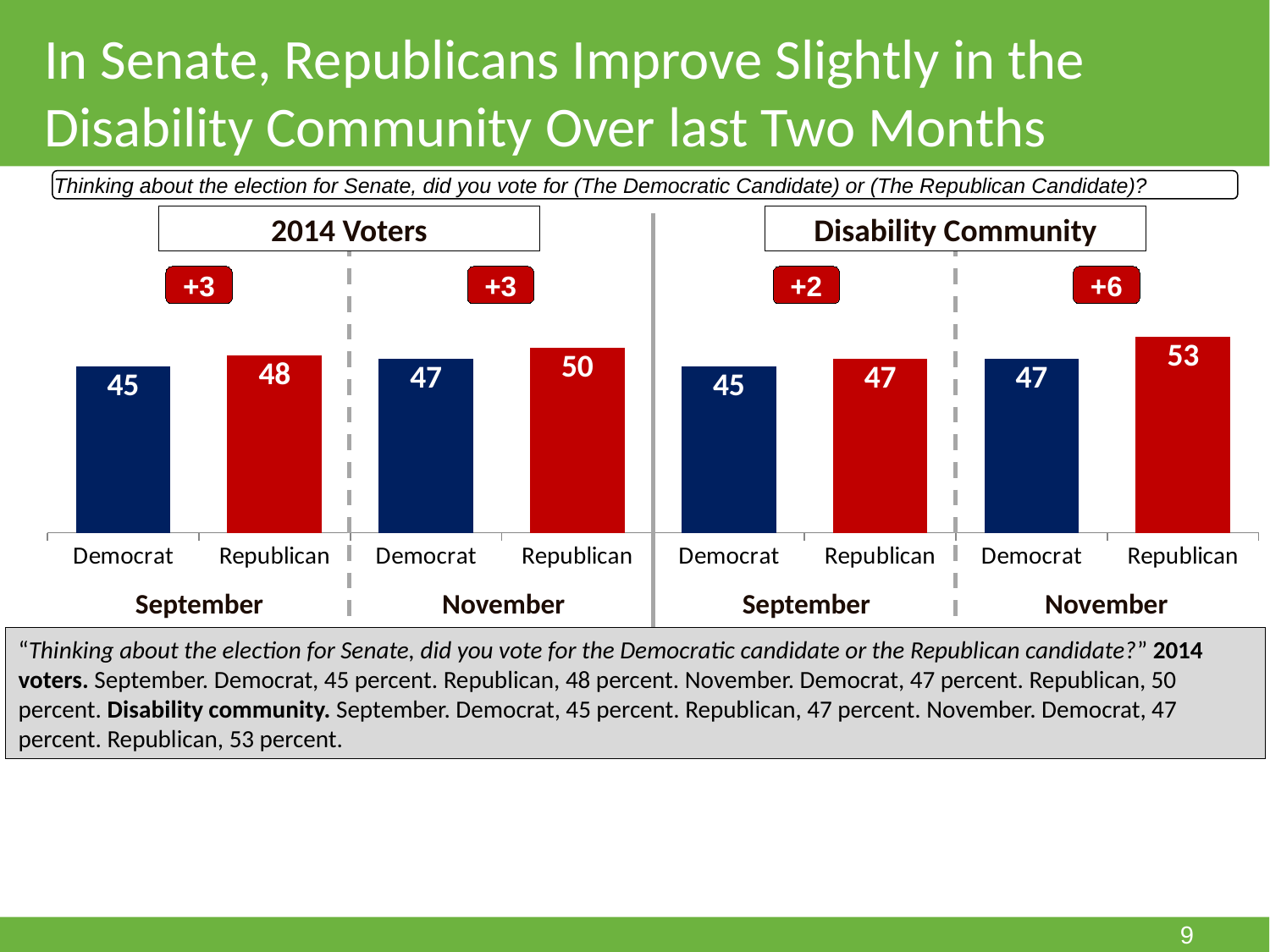
In the 2014 Voters chart, which is larger in September: Democrat or Republican? Republican What kind of chart is used on this slide? Bar chart In the Disability Community chart, what is the gain label shown above the November bars? +6 In the 2014 Voters chart, what is the value for Republican in November? 50 In the 2014 Voters chart, which bar is the lowest? Democrat, September In the 2014 Voters chart, what is the value for Democrat in September? 45 In the Disability Community chart, what is the difference between Republican and Democrat in November? 6 How many bars are plotted in the Disability Community chart? 4 In the Disability Community chart, what is the value for Republican in November? 53 In the 2014 Voters chart, what is the difference between Republican in November and Republican in September? 2 In the Disability Community chart, what is the value for Democrat in September? 45 In the Disability Community chart, which bar is the highest? Republican, November